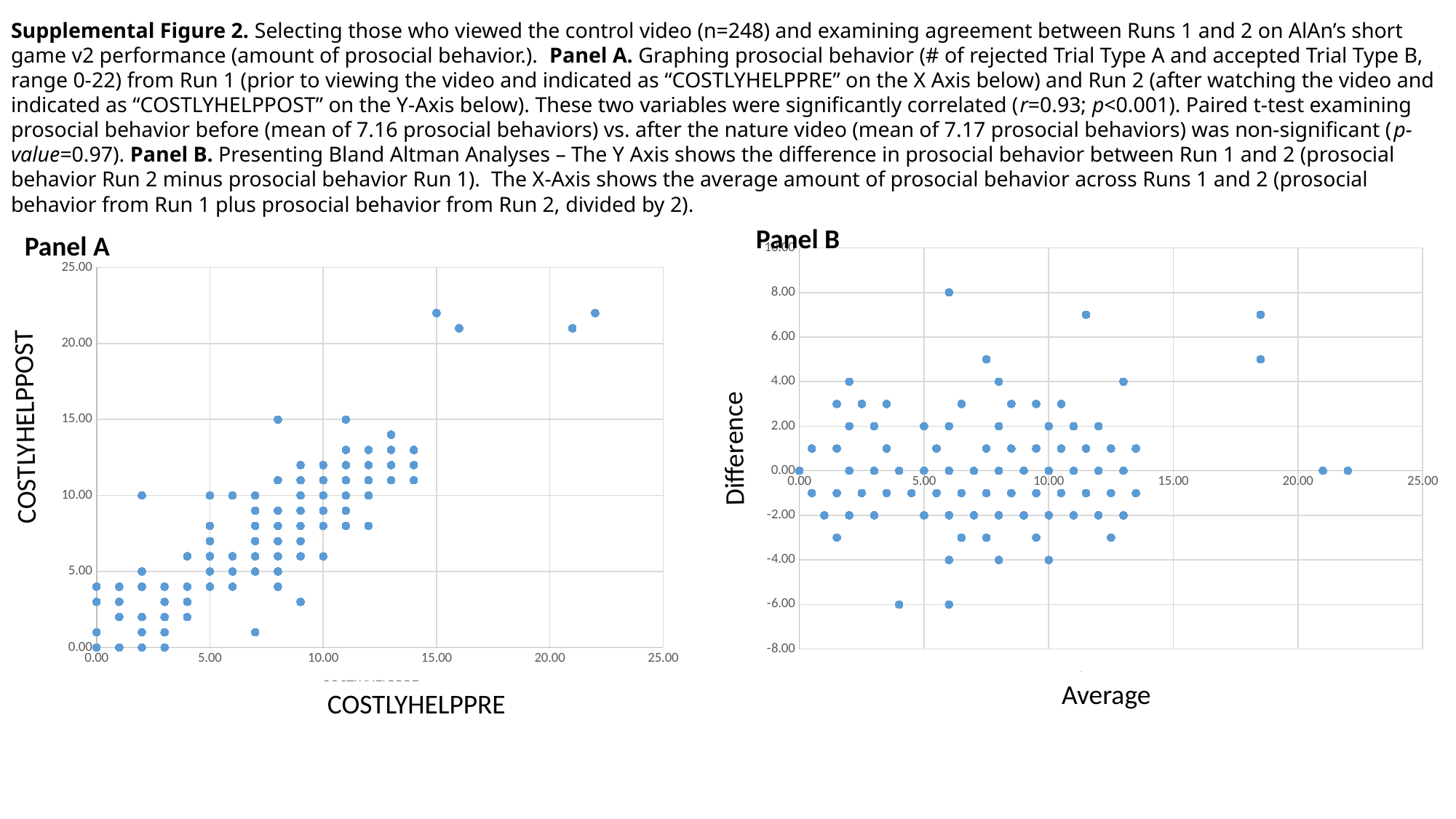
What kind of chart is Panel B? scatter chart What is the maximum value shown on the x axis of Panel B? 25.00 In Panel B, what is the highest Difference value plotted? 8.00 In Panel A, what is the label of the x axis? COSTLYHELPPRE In Panel B, is the highest Difference value plotted greater or less than 6.00? greater In Panel B, are the points with Average above 20.00 plotted at a Difference greater or less than 2.00? less In Panel A, is the highest COSTLYHELPPOST value plotted greater or less than 20.00? greater In Panel A, do the COSTLYHELPPOST values generally rise or fall as COSTLYHELPPRE increases? rise What kind of chart is Panel A? scatter chart In Panel B, what is the label of the y axis? Difference In Panel B, what is the lowest Difference value plotted? -6.00